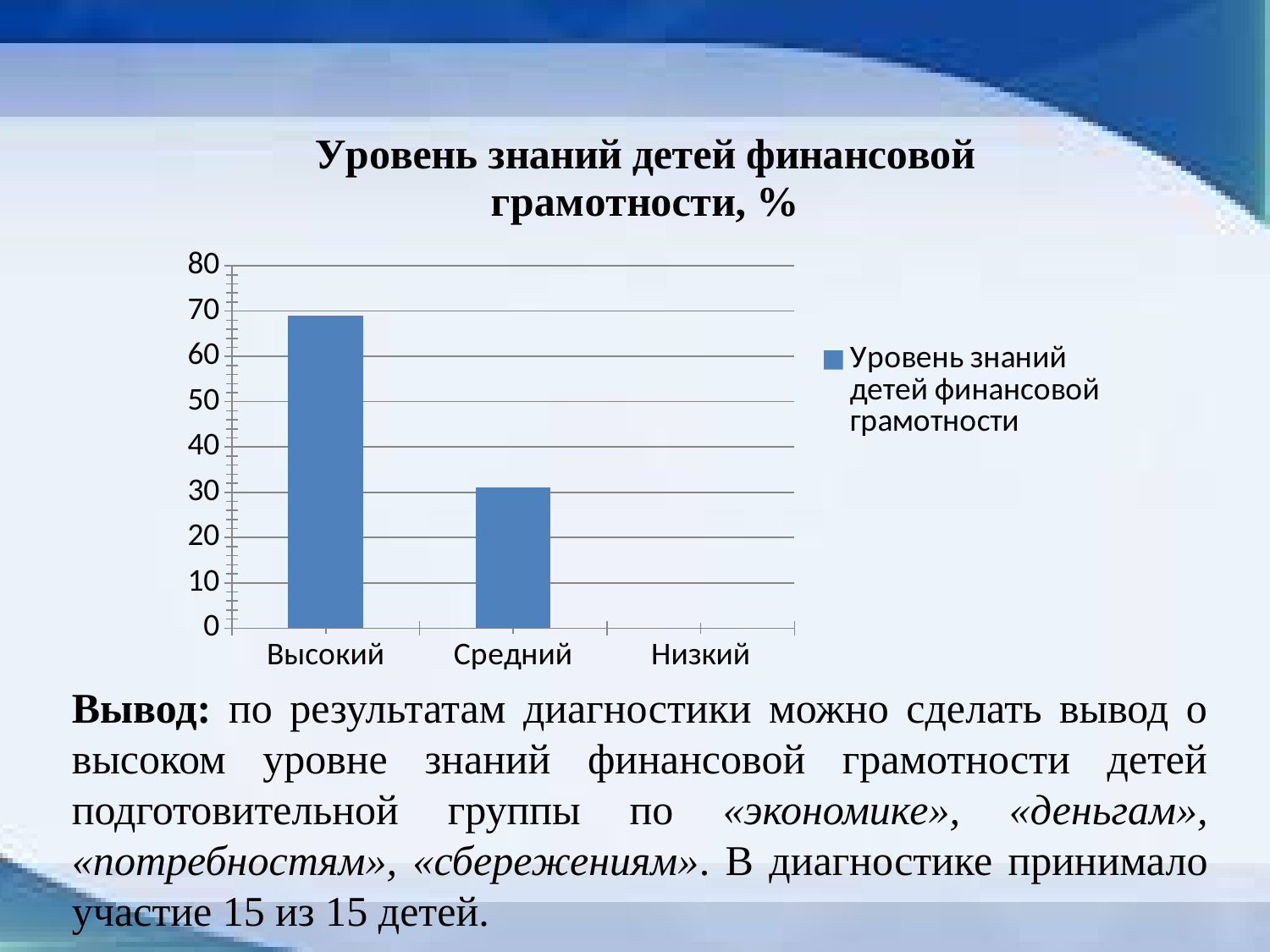
How many series does the legend list? 1 What is the title of the chart? Уровень знаний детей финансовой грамотности, % Which category has the lowest value? Низкий Which is larger, the value for Высокий or the value for Средний? Высокий What kind of chart is shown on the slide? bar chart How many categories are shown on the x axis of the chart? 3 Is the value for Средний greater or less than 20? greater Is the value for Средний greater or less than 40? less Is the value for Высокий greater or less than 60? greater Do the values rise or fall moving from Высокий to Низкий along the x axis? fall Which category has the highest value? Высокий